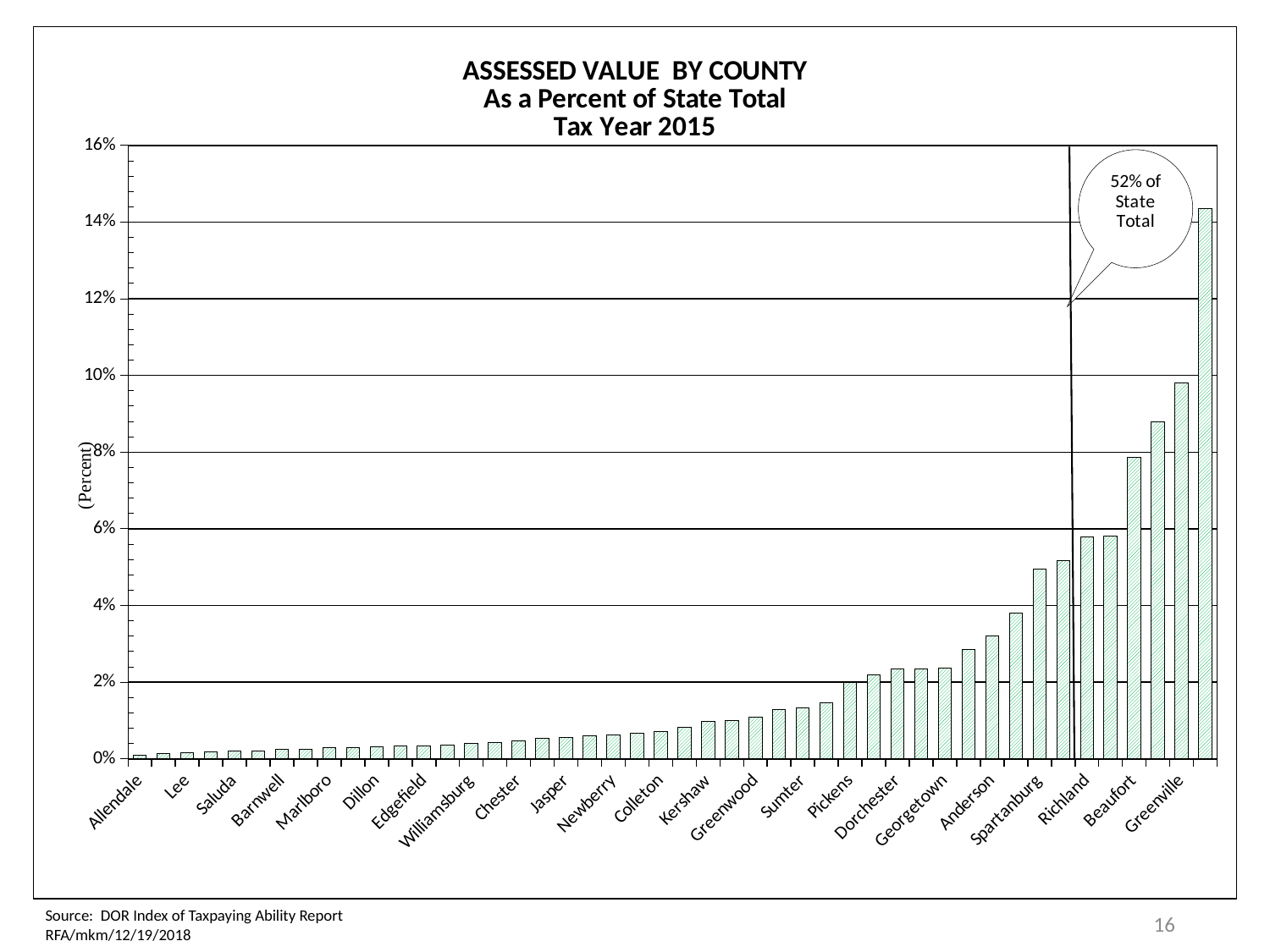
Is the value for Beaufort greater or less than 6%? greater Is the value for Sumter greater or less than 2%? less Which has the larger value, Greenville or Allendale? Greenville Is the value for Richland greater or less than 4%? greater How many county names are labeled on the x axis? 23 What is the title of the chart? ASSESSED VALUE BY COUNTY As a Percent of State Total Tax Year 2015 Do the bar values rise or fall moving from left to right along the x axis? rise What does the callout on the chart say about the counties to the right of the vertical line? 52% of State Total What kind of chart is shown on the slide? bar chart